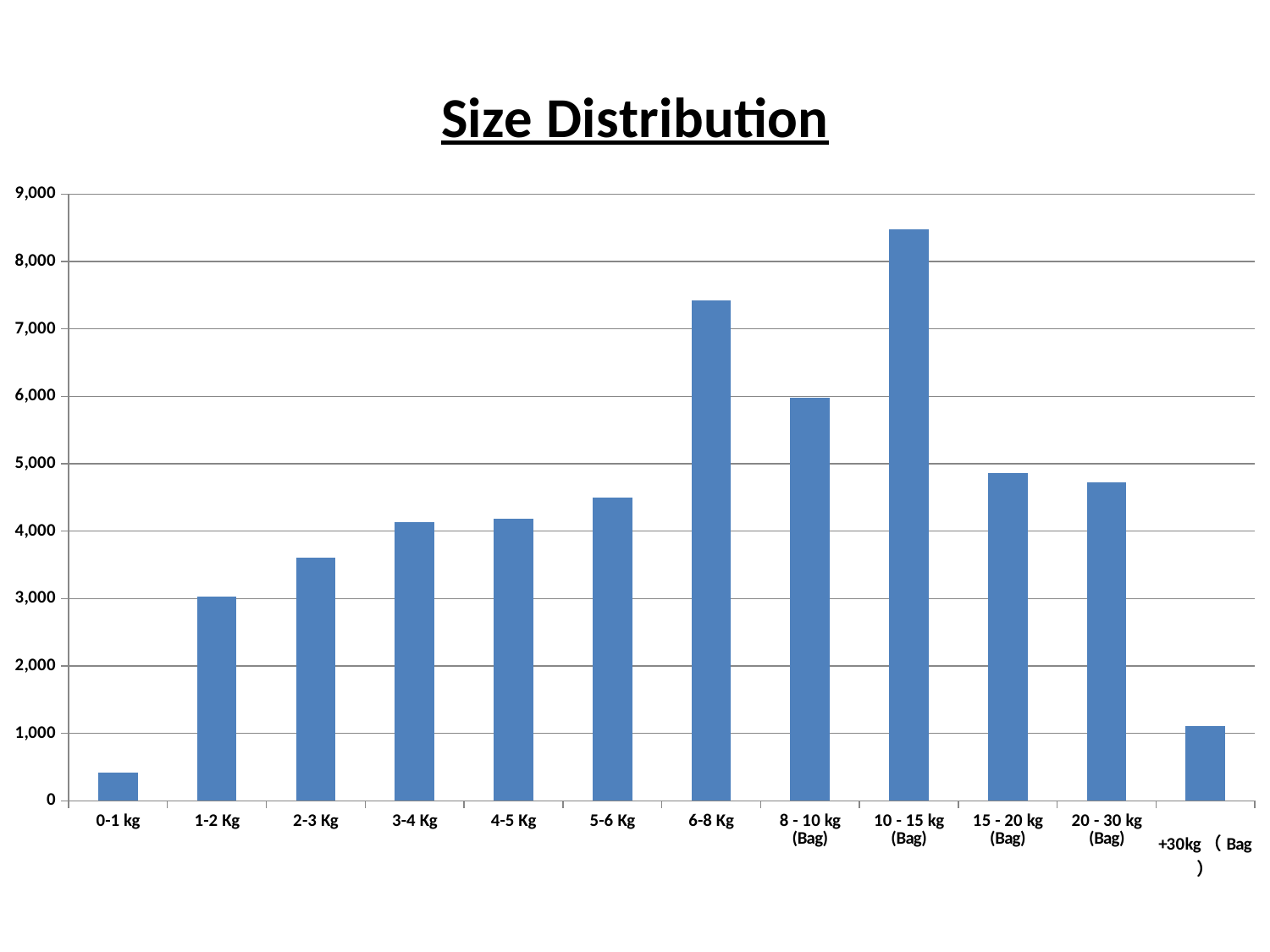
Is the value for 0-1 kg greater or less than 1,000? less What type of chart is shown on the slide? Bar chart Which has a larger value, 2-3 Kg or 3-4 Kg? 3-4 Kg How many size categories are shown on the x axis? 12 Which size category has the lowest value? 0-1 kg What is the title of the chart? Size Distribution Is the value for 10 - 15 kg (Bag) greater or less than 8,000? greater Is the value for 2-3 Kg greater or less than 4,000? less Which has a larger value, 6-8 Kg or 8 - 10 kg (Bag)? 6-8 Kg Which size category has the highest value? 10 - 15 kg (Bag) Do the values rise or fall from 0-1 kg through 6-8 Kg? Rise